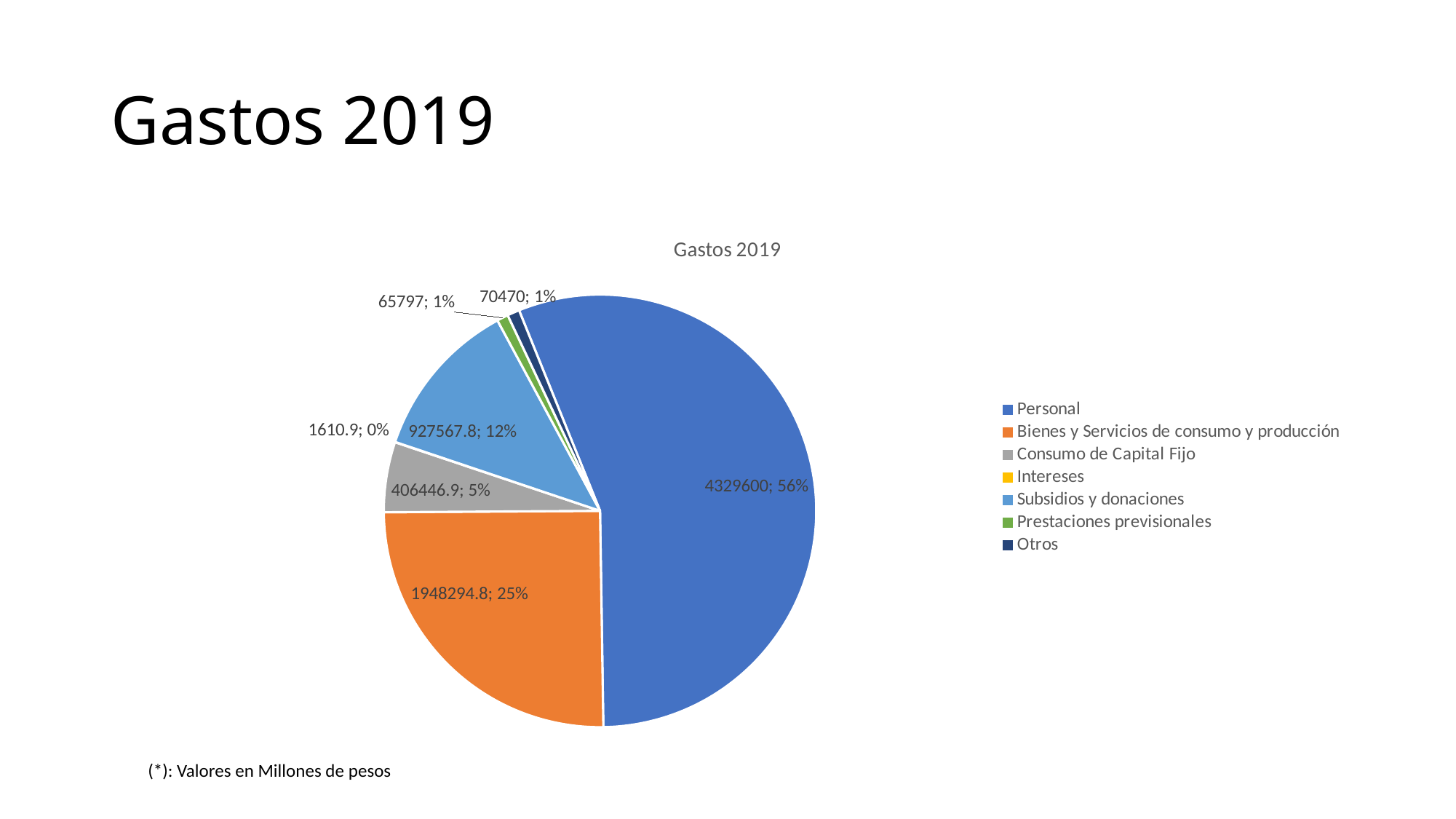
What is the value for Bienes y Servicios de consumo y producción? 1948294.8 Which is larger, Otros or Prestaciones previsionales? Otros Which category has the smallest slice? Intereses What is the value for Consumo de Capital Fijo? 406446.9 How many categories does the legend list? 7 Which category has the largest slice? Personal What is the value for Personal? 4329600 What is the title of the chart? Gastos 2019 What share of the pie does Personal represent? 56% What kind of chart is shown on the slide? pie chart What share of the pie does Subsidios y donaciones represent? 12% What is the value for Intereses? 1610.9